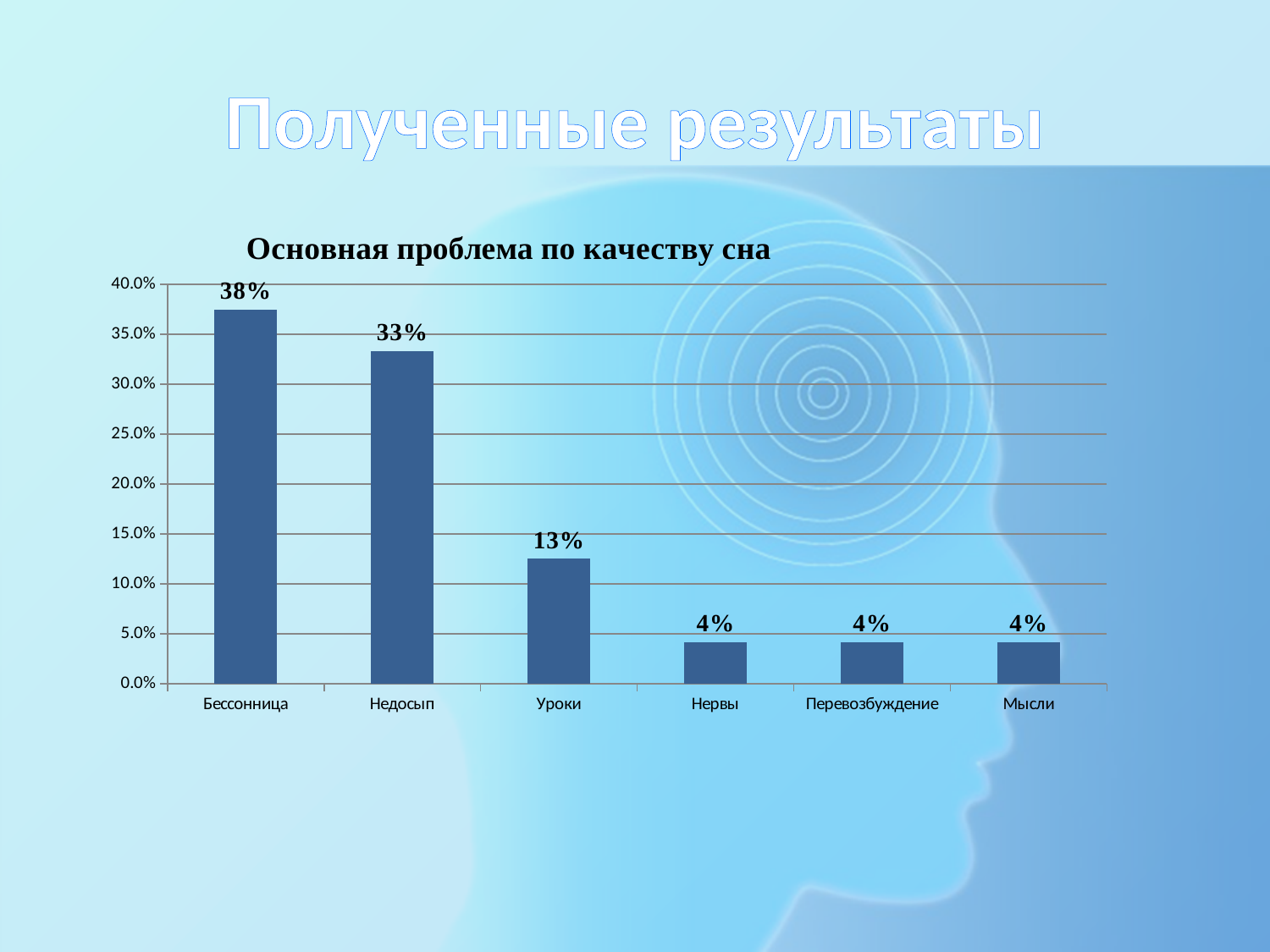
What is the difference between the values for Недосып and Уроки? 20% What is the title of the chart? Основная проблема по качеству сна What is the value for Уроки? 13% What is the difference between the values for Бессонница and Недосып? 5% What is the value for Перевозбуждение? 4% Is the value for Уроки greater or less than 10.0%? greater What kind of chart is shown on the slide? bar chart What is the value for Недосып? 33% Which is larger, the value for Уроки or the value for Нервы? Уроки Which category has the highest value? Бессонница How many categories are shown on the x axis? 6 What is the value for Бессонница? 38%